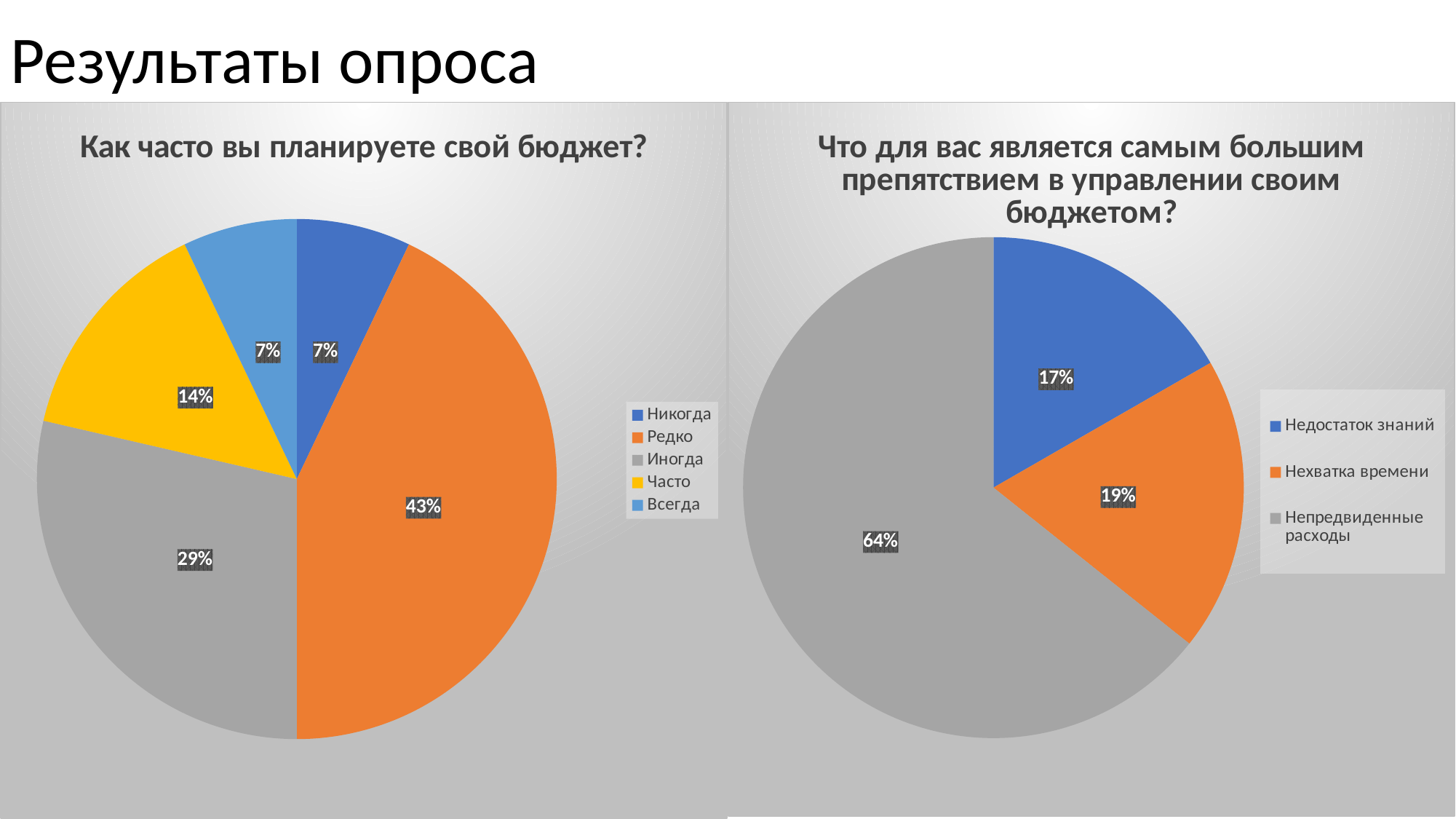
In the left chart 'Как часто вы планируете свой бюджет?', which category has the largest slice? Редко What type of chart is the right chart about the biggest obstacle in managing a budget? Pie chart In the left chart 'Как часто вы планируете свой бюджет?', how many categories does the legend list? 5 In the left chart 'Как часто вы планируете свой бюджет?', what share is labelled for 'Иногда'? 29% In the right chart about the biggest obstacle in managing a budget, what share is labelled for 'Недостаток знаний'? 17% In the right chart about the biggest obstacle in managing a budget, what colour is the slice for 'Непредвиденные расходы'? Grey In the left chart 'Как часто вы планируете свой бюджет?', what share is labelled for 'Редко'? 43% In the left chart 'Как часто вы планируете свой бюджет?', what share is labelled for 'Часто'? 14% In the right chart about the biggest obstacle in managing a budget, what share is labelled for 'Непредвиденные расходы'? 64% In the right chart about the biggest obstacle in managing a budget, which is larger: 'Нехватка времени' or 'Недостаток знаний'? Нехватка времени In the right chart about the biggest obstacle in managing a budget, which category has the smallest slice? Недостаток знаний In the left chart 'Как часто вы планируете свой бюджет?', what is the difference between the shares for 'Редко' and 'Иногда'? 14%